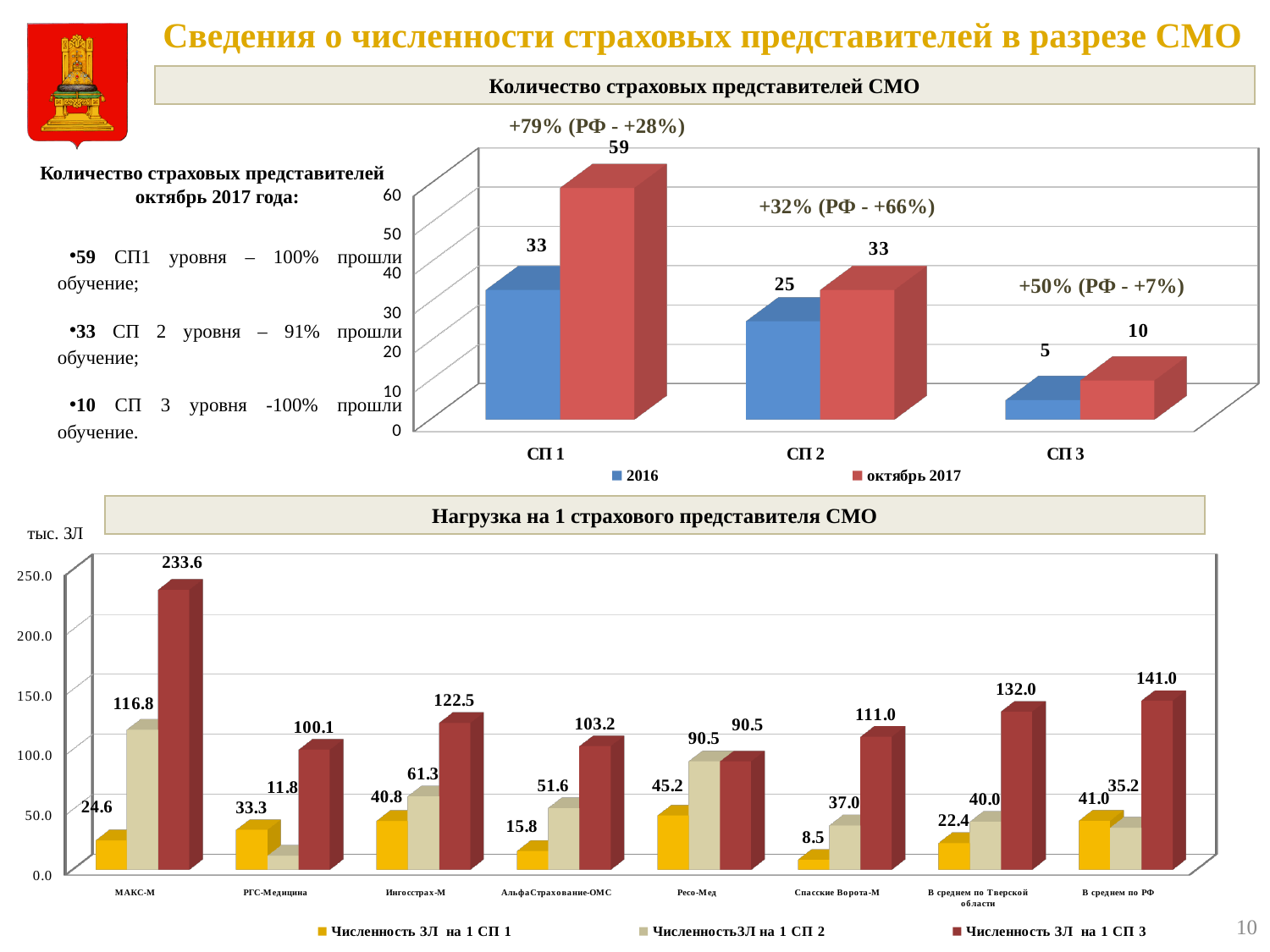
In the chart 'Количество страховых представителей СМО', what is the value for СП 2 in the '2016' series? 25 What kind of chart is 'Нагрузка на 1 страхового представителя СМО'? Bar chart How many series does the legend of the chart 'Количество страховых представителей СМО' list? 2 In the chart 'Нагрузка на 1 страхового представителя СМО', which category has the highest value in the 'Численность ЗЛ на 1 СП 3' series? МАКС-М In the chart 'Нагрузка на 1 страхового представителя СМО', which is larger for Ингосстрах-М: the 'Численность ЗЛ на 1 СП 1' value or the 'Численность ЗЛ на 1 СП 2' value? Численность ЗЛ на 1 СП 2 In the chart 'Нагрузка на 1 страхового представителя СМО', what is the value for МАКС-М in the 'Численность ЗЛ на 1 СП 3' series? 233.6 In the chart 'Нагрузка на 1 страхового представителя СМО', what is the difference between the 'Численность ЗЛ на 1 СП 3' values for 'В среднем по РФ' and 'В среднем по Тверской области'? 9.0 In the chart 'Количество страховых представителей СМО', what is the difference between the 'октябрь 2017' and '2016' values for СП 1? 26 In the chart 'Количество страховых представителей СМО', which category has the lowest value in the 'октябрь 2017' series? СП 3 In the chart 'Нагрузка на 1 страхового представителя СМО', what is the value for Спасские Ворота-М in the 'Численность ЗЛ на 1 СП 1' series? 8.5 In the chart 'Количество страховых представителей СМО', what is the value for СП 1 in the 'октябрь 2017' series? 59 How many categories are shown on the x axis of the chart 'Нагрузка на 1 страхового представителя СМО'? 8